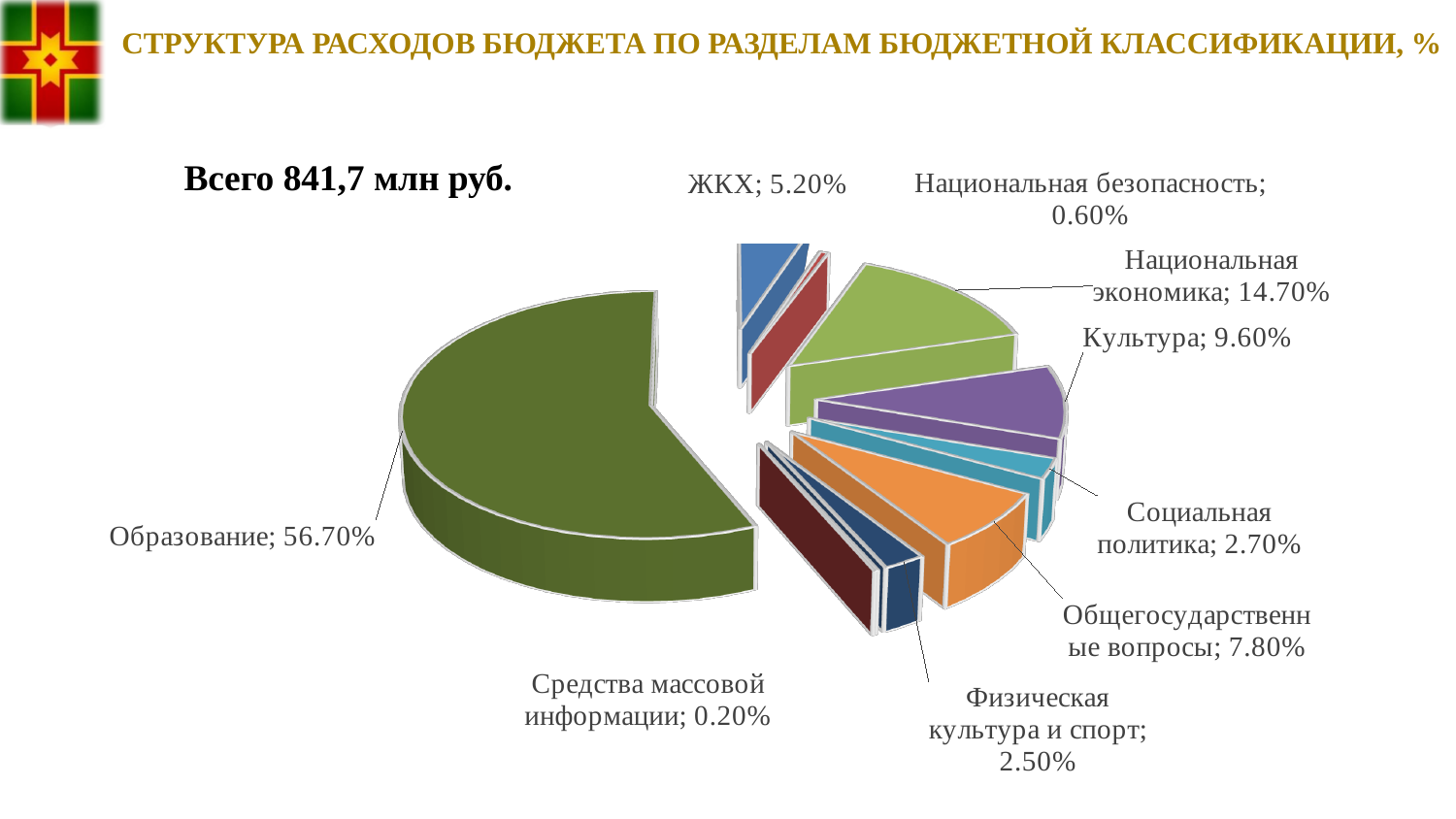
What kind of chart is shown on the slide? pie chart Which is larger, the share for ЖКХ or the share for Общегосударственные вопросы? Общегосударственные вопросы What total budget amount is stated on the slide? 841,7 млн руб. Which category has the largest share of the pie? Образование What is the share for Национальная экономика? 14.70% What is the share for Образование? 56.70% How many categories are shown in the pie chart? 9 What is the share for Средства массовой информации? 0.20% What is the difference between the shares of Национальная экономика and Культура? 5.10% What is the difference between the shares of Социальная политика and Физическая культура и спорт? 0.20% What is the share for Культура? 9.60% Which category has the smallest share of the pie? Средства массовой информации